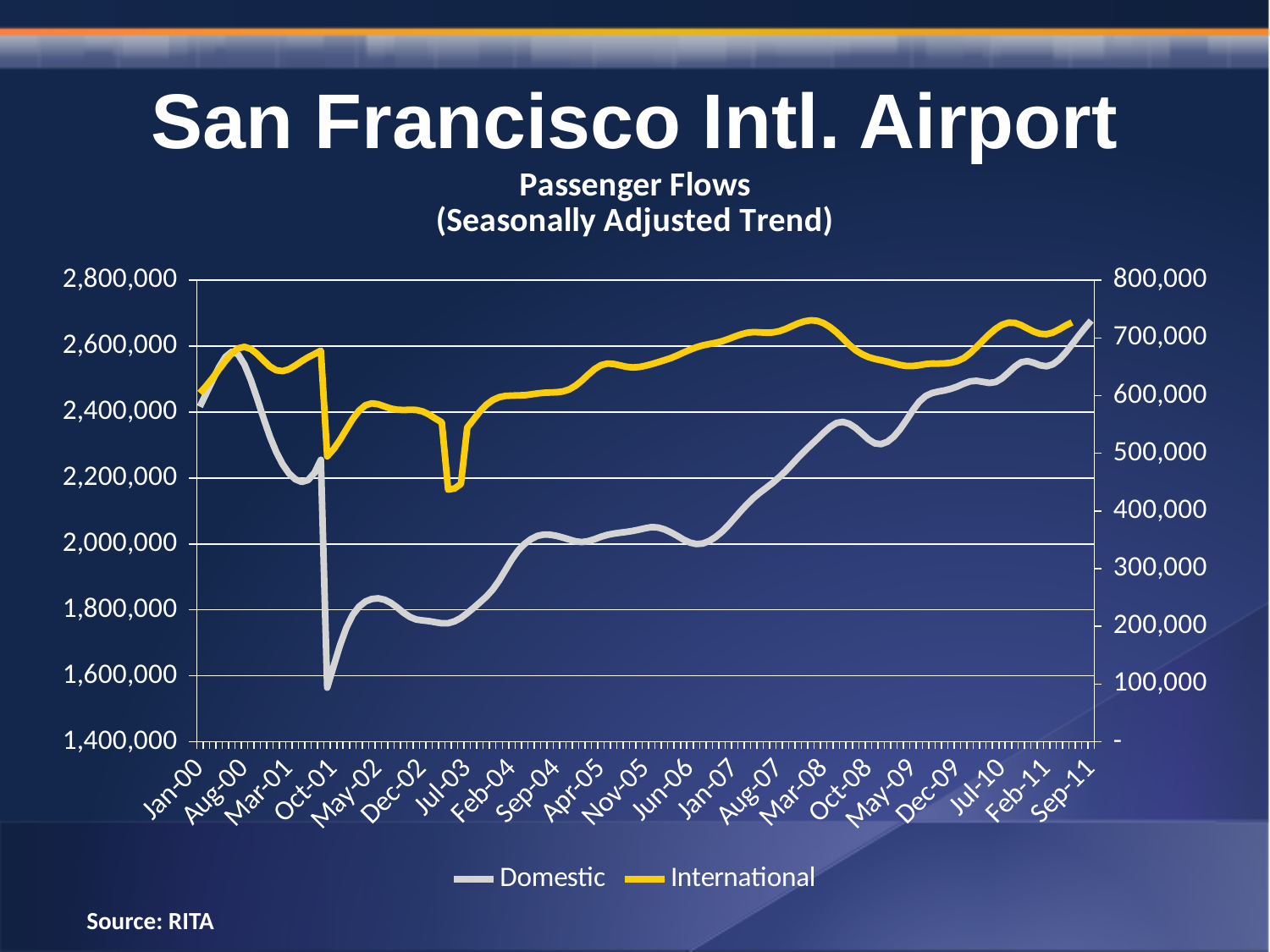
Around which x-axis label does the Domestic series reach its lowest point? Oct-01 Does the Domestic series rise or fall between Jan-07 and Mar-08? rise How many series does the legend list? 2 What kind of chart is shown on the slide? line chart Is the Domestic value at its lowest point (around Oct-01) greater or less than 1,600,000? less Is the International value at its peak around Mar-08 greater or less than 700,000? greater What source is cited for the chart data? RITA What are the two series named in the legend? Domestic and International Is the Domestic value at Sep-11 greater or less than 2,600,000? greater Does the Domestic series rise or fall between Aug-00 and Oct-01? fall